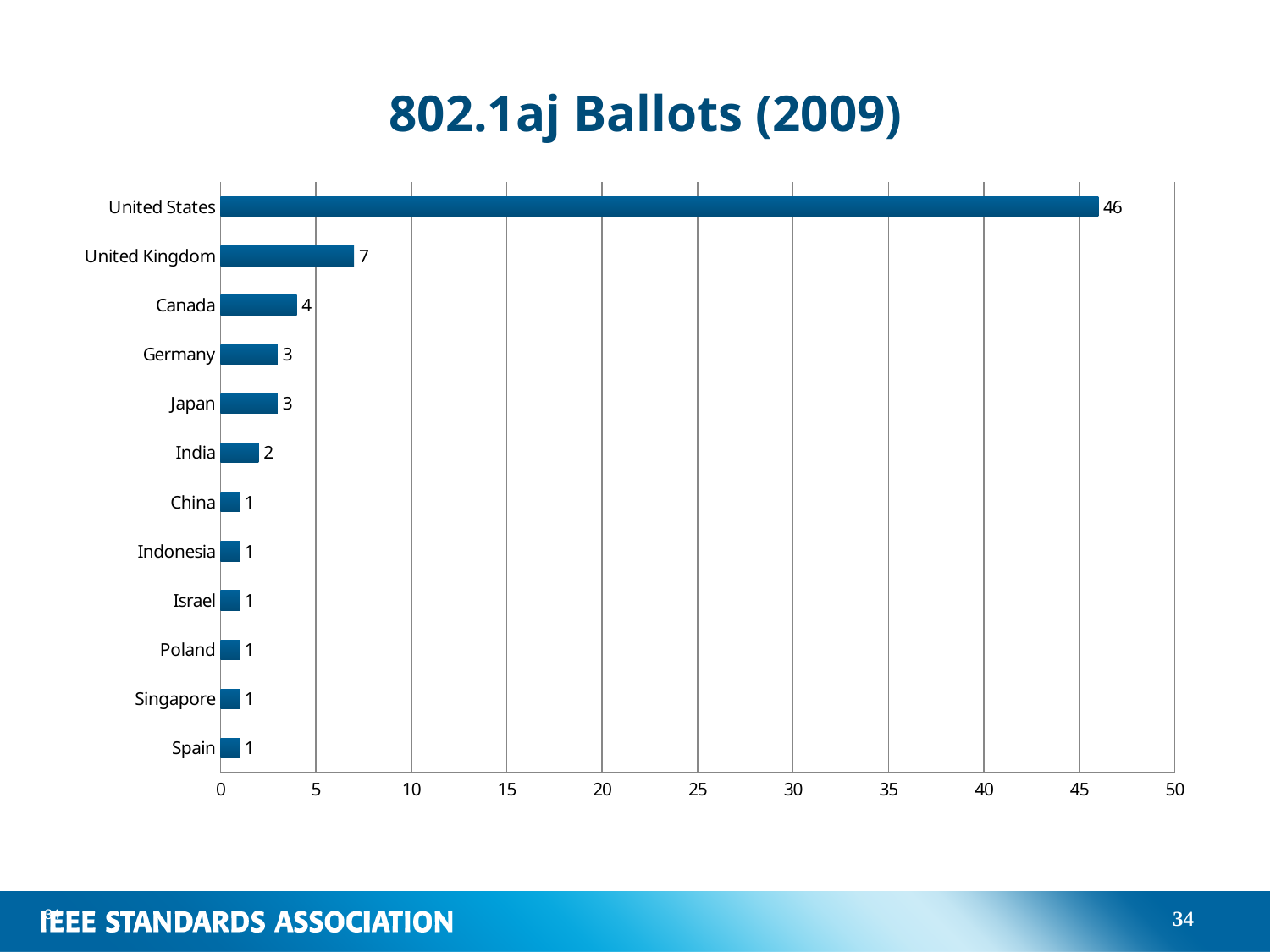
What is the value for Canada? 4 Is the value for the United States greater or less than 40? greater What kind of chart is shown on the slide? Bar chart How many countries are shown in the chart? 12 What is the title of the chart? 802.1aj Ballots (2009) Which is larger, the value for the United Kingdom or the value for Japan? United Kingdom Which country has the highest number of ballots? United States What is the value for the United Kingdom? 7 What is the value for India? 2 What is the value for the United States? 46 What is the difference between the values for Canada and Germany? 1 What is the difference between the values for the United States and the United Kingdom? 39